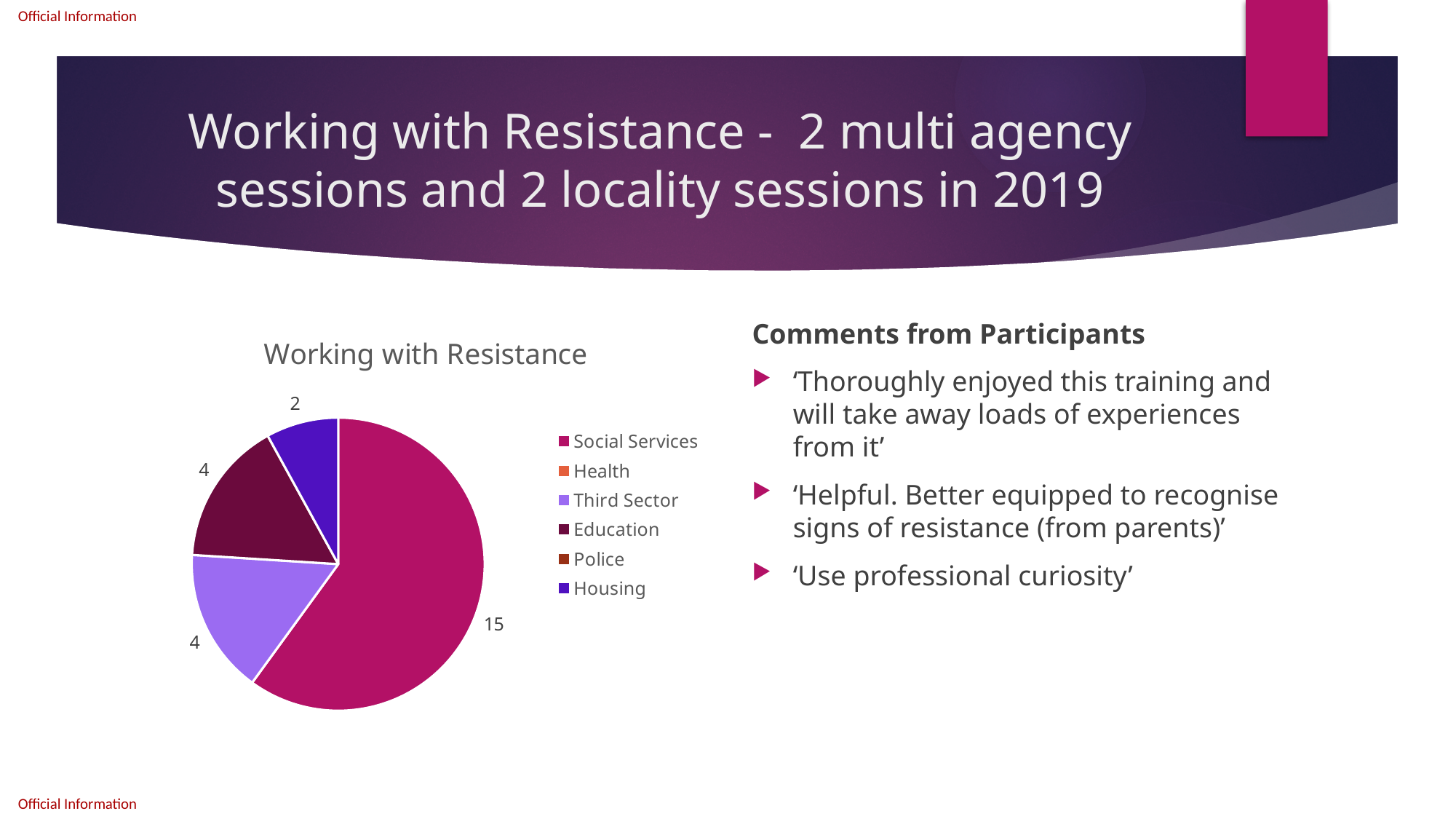
Which category has the largest slice in the pie chart? Social Services What is the difference between the values for Social Services and Housing? 13 Which labelled slice in the pie chart has the smallest value? Housing What is the title of the pie chart? Working with Resistance Which is larger, the value for Social Services or the value for Third Sector? Social Services How many entries does the legend of the pie chart list? 6 What is the value for Third Sector in the pie chart? 4 What is the difference between the values for Social Services and Education? 11 What is the value for Education in the pie chart? 4 What is the value for Social Services in the pie chart? 15 What is the value for Housing in the pie chart? 2 What kind of chart is shown on the slide? pie chart